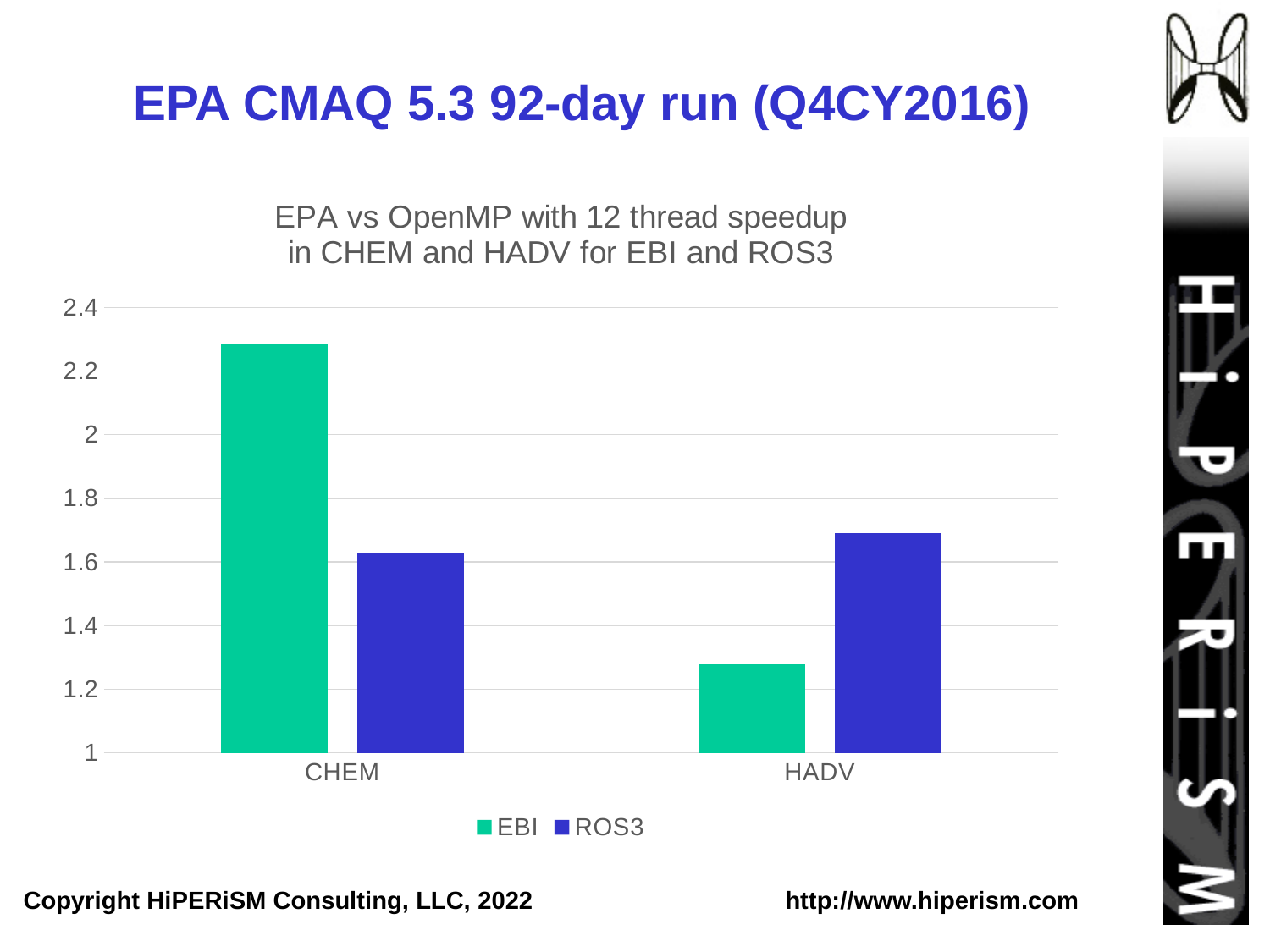
What colour are the ROS3 bars in the chart? blue Which series and category has the highest bar in the chart? EBI for CHEM For HADV, which series has the larger speedup, EBI or ROS3? ROS3 How many categories are shown on the x axis of the chart? 2 What kind of chart is shown on the slide? bar chart For CHEM, which series has the larger speedup, EBI or ROS3? EBI Is the ROS3 speedup for CHEM greater or less than 1.8? less Is the EBI speedup for HADV greater or less than 1.4? less How many series does the chart legend list? 2 Is the EBI speedup for CHEM greater or less than 2.2? greater Which series and category has the lowest bar in the chart? EBI for HADV